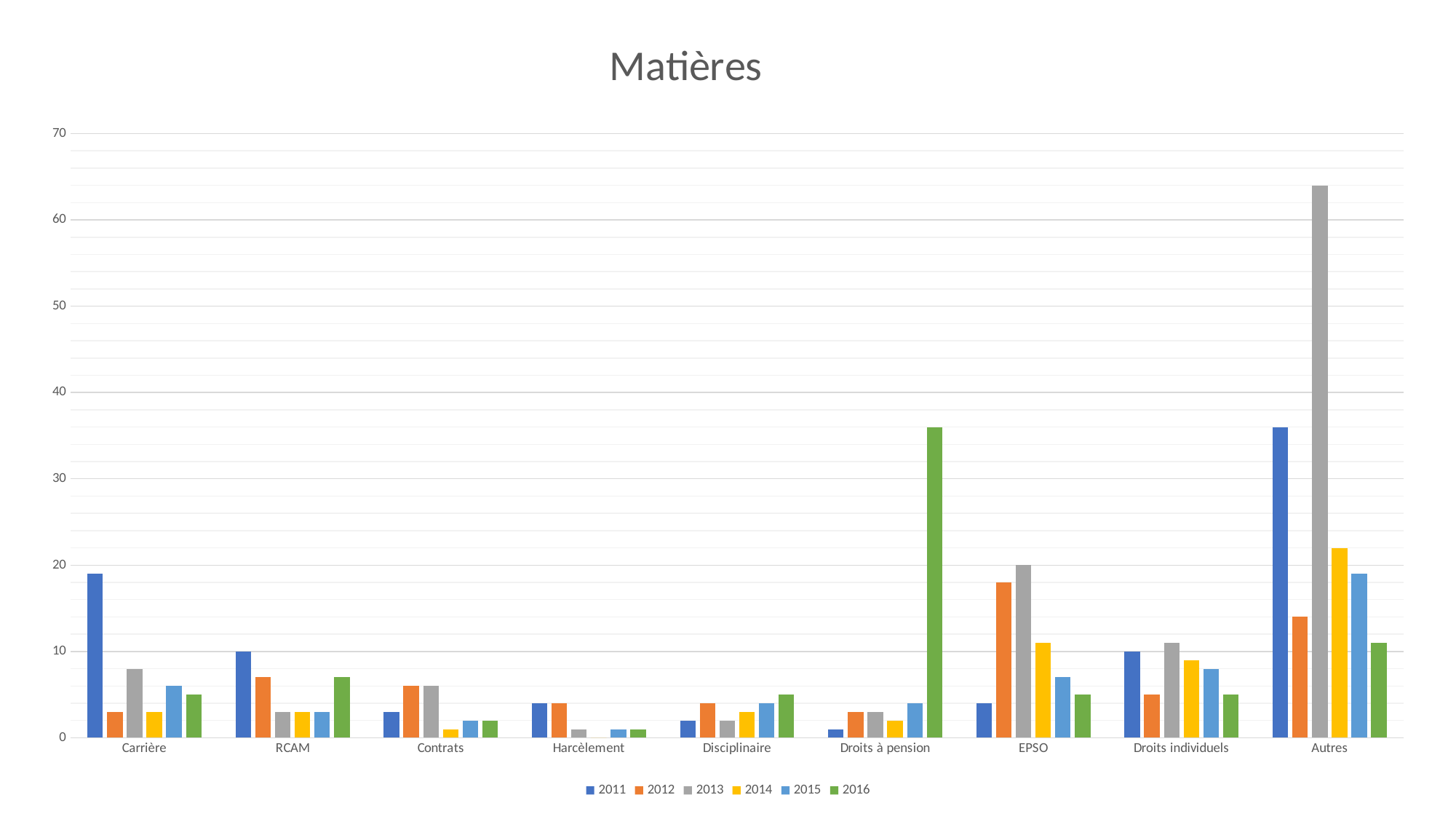
Which category has the highest value for the 2016 series? Droits à pension For EPSO, which is larger: the 2012 value or the 2015 value? 2012 What kind of chart is shown on the slide? bar chart For Carrière, which is larger: the 2011 value or the 2012 value? 2011 Is the 2013 value for Autres greater or less than 60? greater Is the 2016 value for Droits à pension greater or less than 30? greater Which category has the highest value for the 2011 series? Autres How many categories are shown on the x axis? 9 In the Autres category, which series has the highest bar? 2013 How many series does the legend list? 6 Is the 2011 value for Autres greater or less than 30? greater What is the title of the chart? Matières